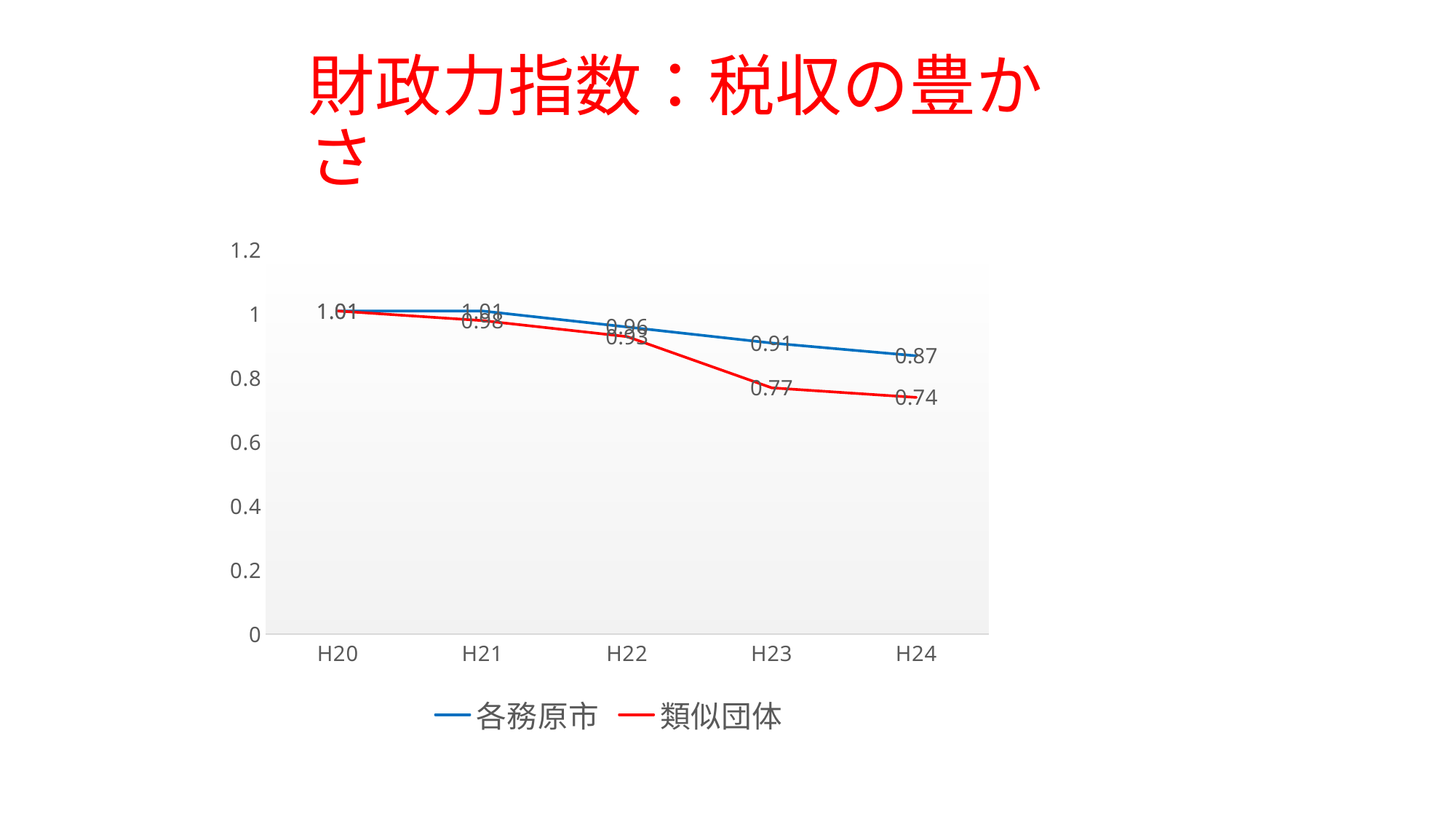
What is the value for 類似団体 at H24? 0.74 What is the value for 各務原市 at H23? 0.91 How many series does the legend list? 2 What is the value for 各務原市 at H24? 0.87 How many years are shown on the x axis? 5 What is the value for 類似団体 at H23? 0.77 What is the difference between 各務原市 and 類似団体 at H24? 0.13 What kind of chart is shown on the slide? line chart Do the values for 類似団体 rise or fall from H20 to H24? fall In which year is the value for 類似団体 lowest? H24 What is the value for 類似団体 at H21? 0.98 At H23, which series has the larger value, 各務原市 or 類似団体? 各務原市